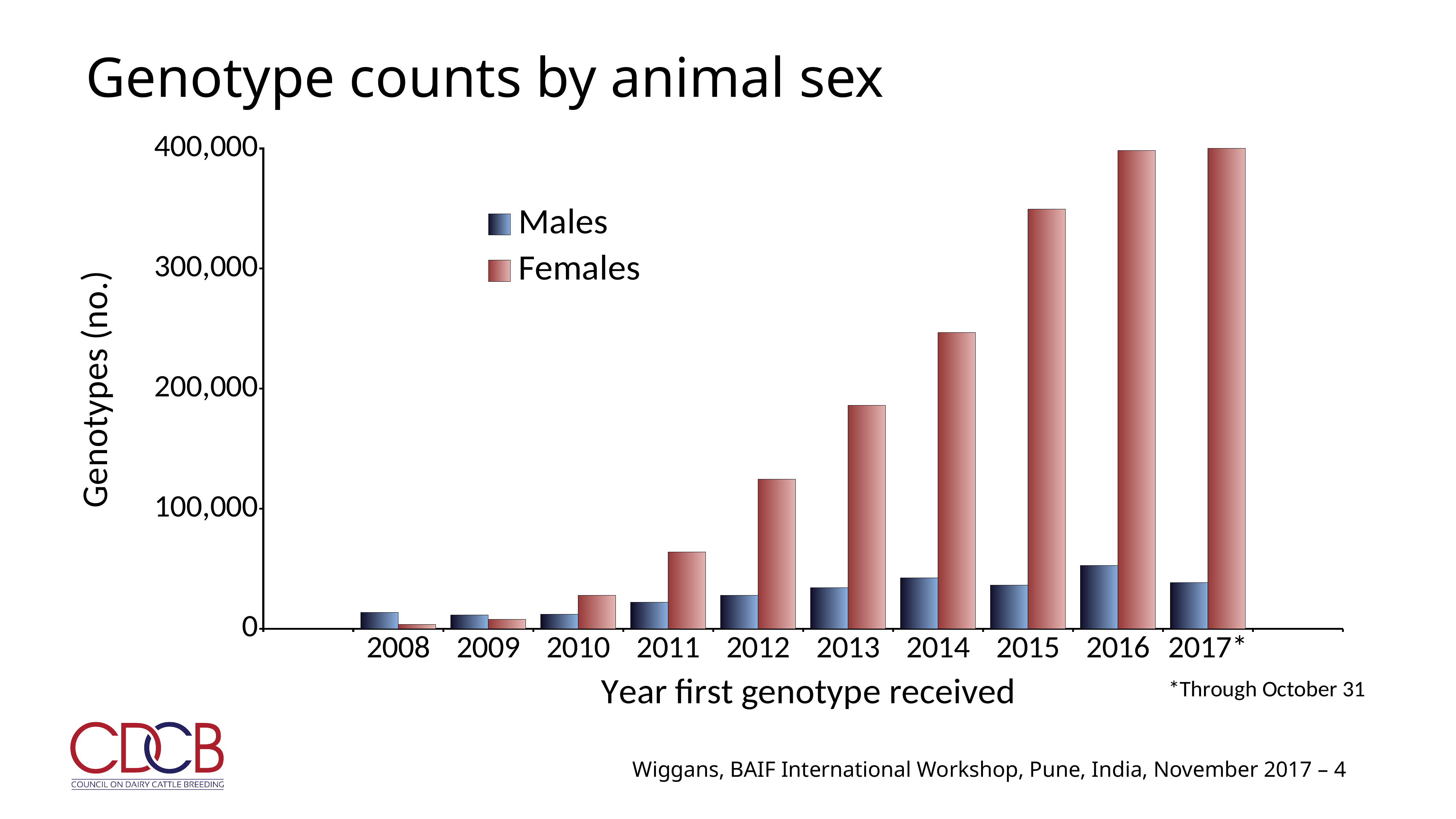
How many years are shown on the x axis? 10 Which year has the lowest value for Females? 2008 In 2008, which is larger, Males or Females? Males Is the value for Females in 2011 greater or less than 100,000? less Is the value for Females in 2014 greater or less than 200,000? greater Is the value for Males in 2016 greater or less than 100,000? less What kind of chart is shown on the slide? bar chart What is the title of the x axis? Year first genotype received How many series does the legend list? 2 Which year has the highest value for Males? 2016 Do the values for Females generally rise or fall from 2008 to 2017*? rise